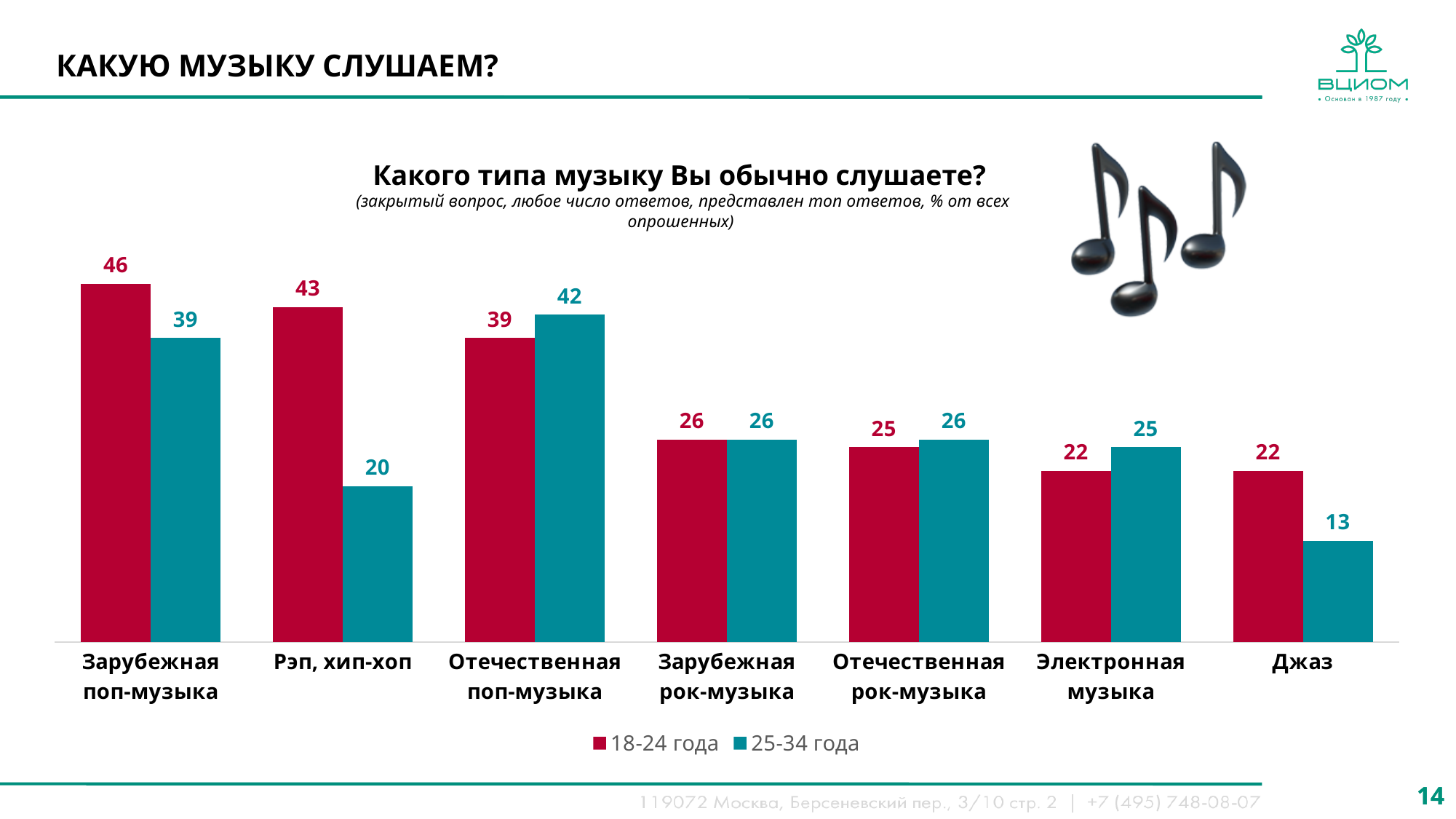
What is the value for Рэп, хип-хоп in the 25-34 года series? 20 Which colour represents the 25-34 года series in the legend? Teal Which category has the lowest value in the 25-34 года series? Джаз What is the value for Зарубежная поп-музыка in the 18-24 года series? 46 For Отечественная поп-музыка, which series has the larger value: 18-24 года or 25-34 года? 25-34 года What is the difference between the 18-24 года and 25-34 года values for Рэп, хип-хоп? 23 What is the difference between the 18-24 года values for Зарубежная поп-музыка and Джаз? 24 Which category has the highest value in the 25-34 года series? Отечественная поп-музыка How many series does the legend list? 2 How many music categories are shown on the x axis? 7 What is the value for Джаз in the 25-34 года series? 13 What kind of chart is shown on the slide? Bar chart